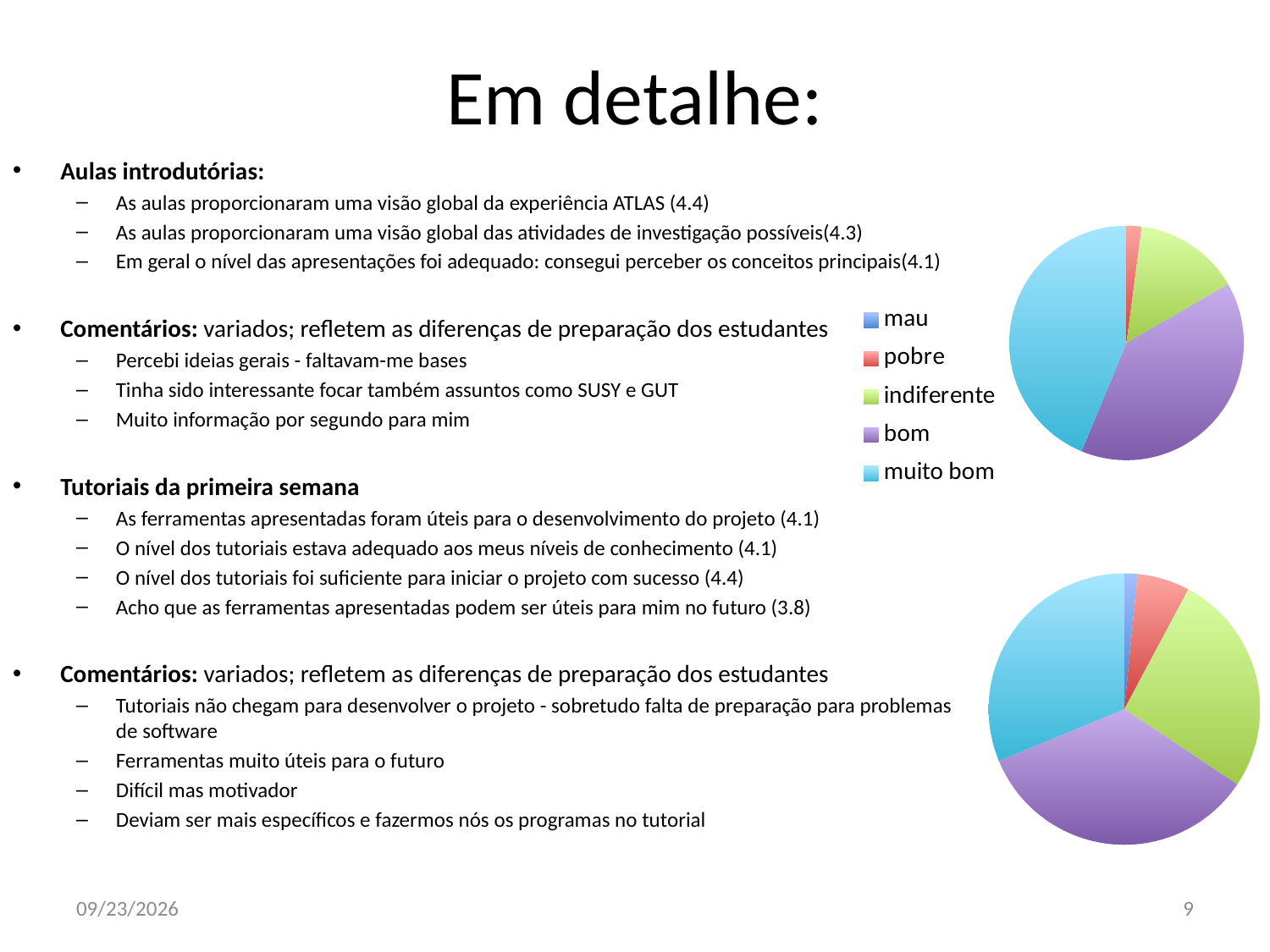
In the top pie chart, which slice is larger: muito bom or indiferente? muito bom In the bottom pie chart, which slice is larger: bom or indiferente? bom How many categories does the legend next to the pie charts list? 5 In the bottom pie chart, which category has the smallest slice? mau Which colour represents the category 'bom' in the pie charts? purple In the top pie chart, which slice is larger: bom or pobre? bom What kind of chart is the bottom chart on the right of the slide? pie chart Which legend entry is listed first next to the pie charts? mau What kind of chart is the top chart on the right of the slide? pie chart